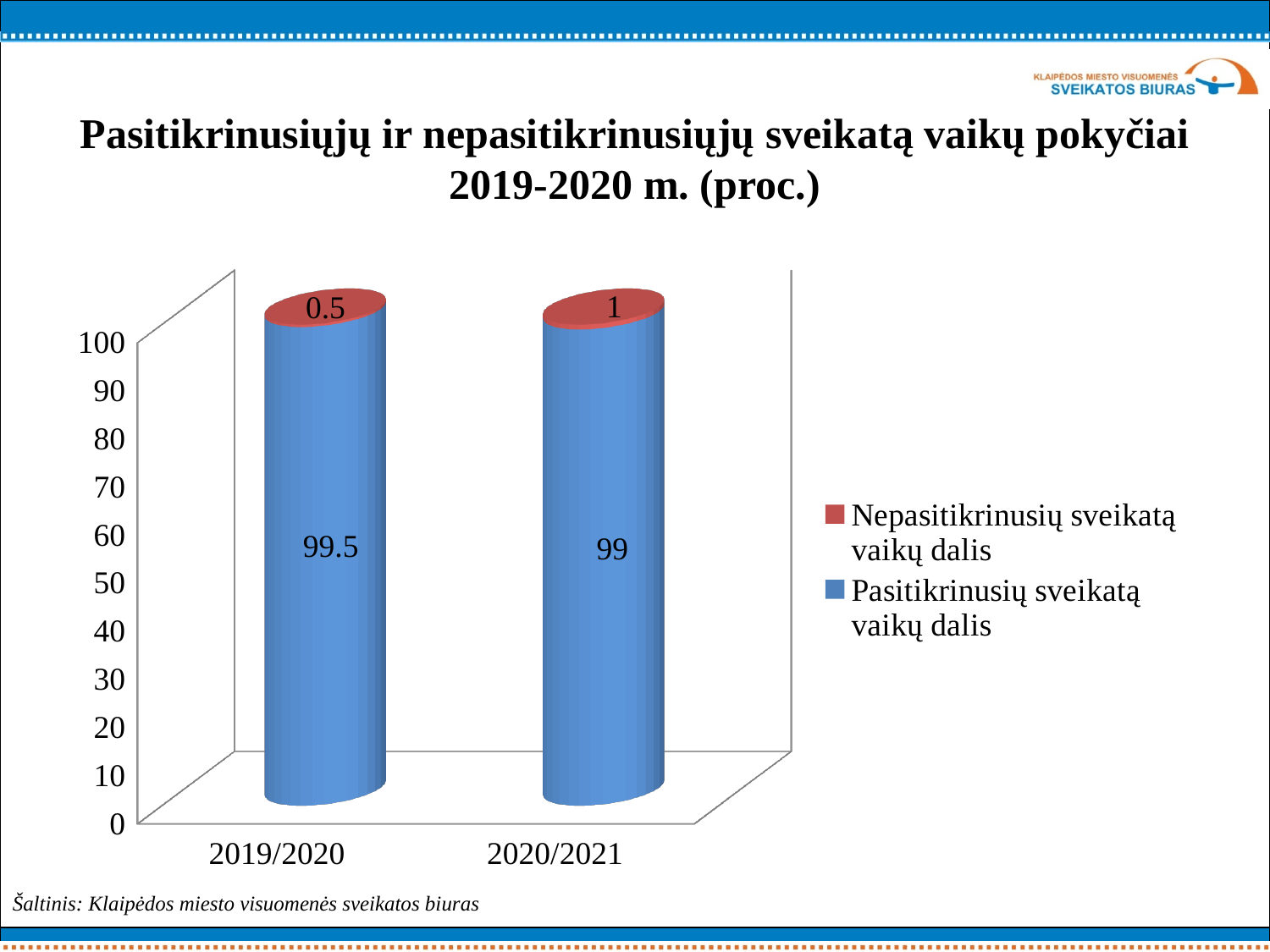
What is the value of 'Pasitikrinusių sveikatą vaikų dalis' for 2020/2021? 99 What is the difference between the 'Pasitikrinusių sveikatą vaikų dalis' values for 2019/2020 and 2020/2021? 0.5 Which colour represents 'Nepasitikrinusių sveikatą vaikų dalis' in the legend? Red How many series does the legend list? 2 Which category has the higher value for 'Nepasitikrinusių sveikatą vaikų dalis'? 2020/2021 What is the total of the stacked bar for 2019/2020? 100 Which category has the lower value for 'Pasitikrinusių sveikatą vaikų dalis'? 2020/2021 What kind of chart is shown on the slide? Stacked bar chart What is the value of 'Pasitikrinusių sveikatą vaikų dalis' for 2019/2020? 99.5 How many categories are shown on the x axis? 2 What is the value of 'Nepasitikrinusių sveikatą vaikų dalis' for 2019/2020? 0.5 What is the value of 'Nepasitikrinusių sveikatą vaikų dalis' for 2020/2021? 1